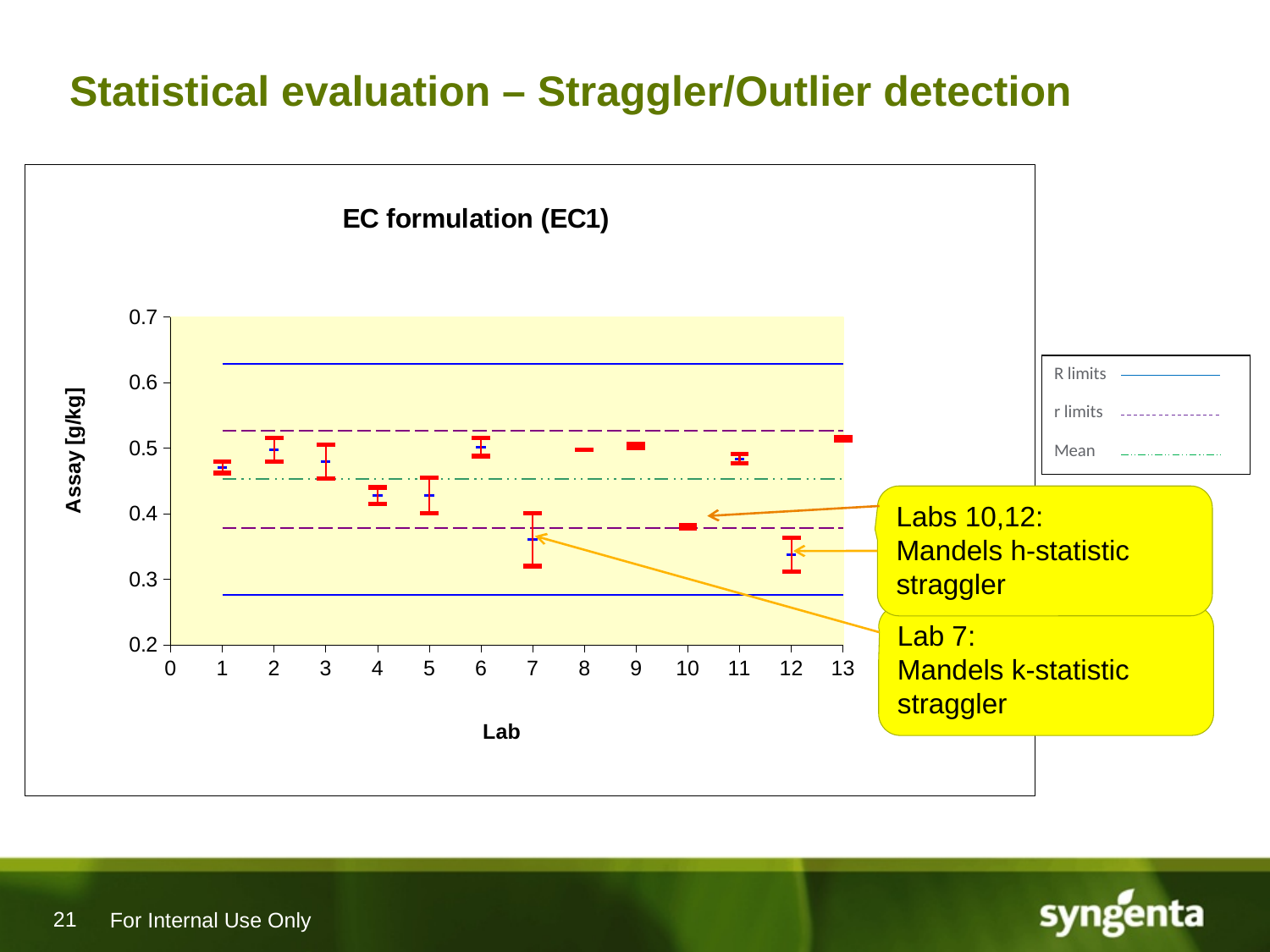
Is the value for Lab 1 greater or less than 0.5? less Is the value for Lab 12 greater or less than 0.4? less Which has the larger value, Lab 13 or Lab 10? Lab 13 What is the label of the y axis of the chart? Assay [g/kg] How many entries does the chart's legend list? 3 Is the value for Lab 13 greater or less than 0.5? greater What is the title of the chart? EC formulation (EC1) Which has the larger value, Lab 6 or Lab 4? Lab 6 How many labs have data points plotted on the chart? 13